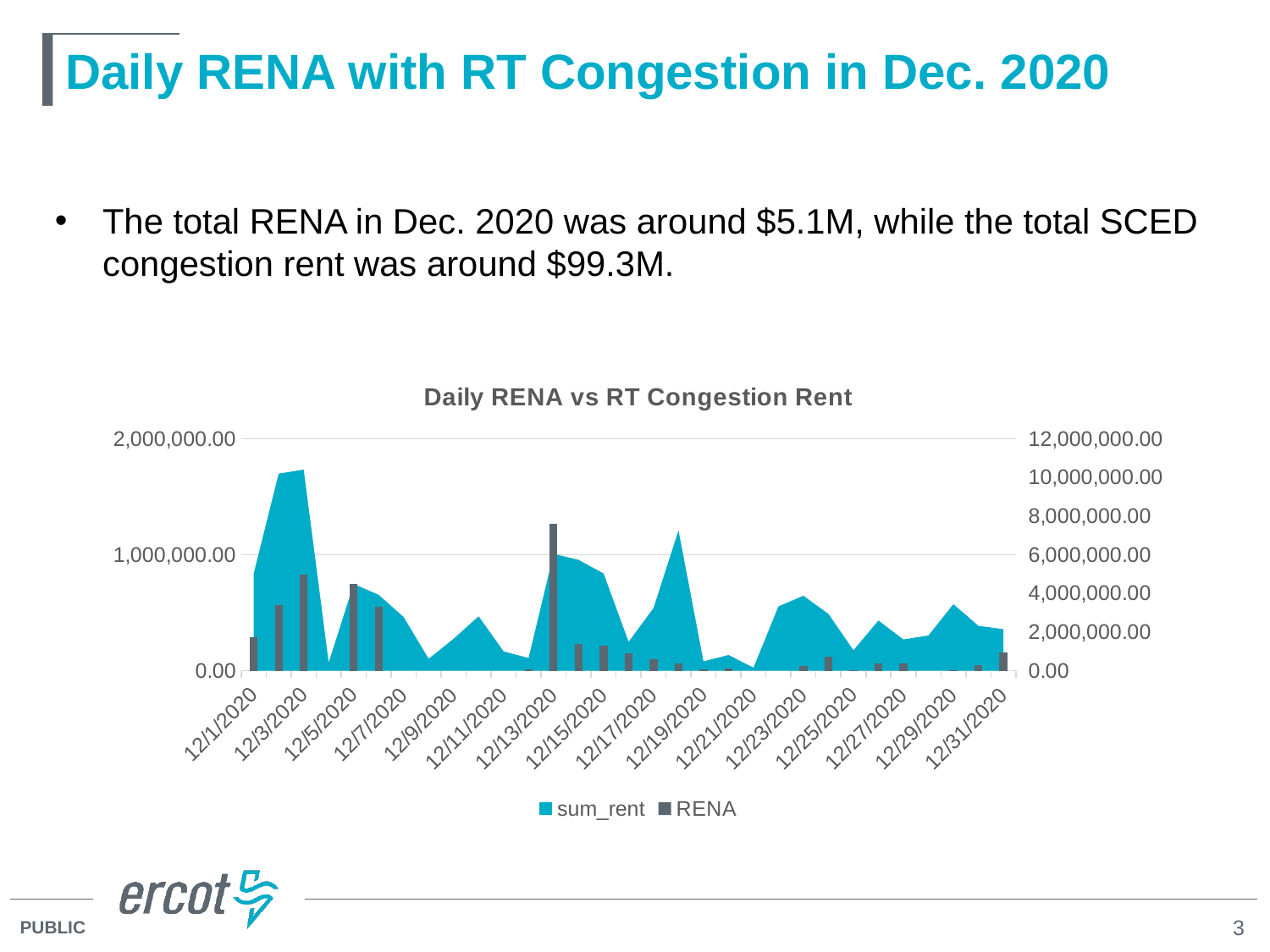
Which date has the larger RENA bar, 12/13/2020 or 12/21/2020? 12/13/2020 How many date labels are shown along the x axis? 16 What kind of chart is used to show the RENA series? bar chart What is the highest tick value shown on the left vertical axis? 2,000,000.00 How many series does the chart legend list? 2 Does the sum_rent series rise or fall between 12/3/2020 and 12/9/2020? fall On which date is the RENA bar the tallest? 12/13/2020 What are the two series named in the chart legend? sum_rent and RENA On which date does the sum_rent series reach its highest value? 12/3/2020 What kind of chart is used to show the sum_rent series? area chart What is the title of the chart on the slide? Daily RENA vs RT Congestion Rent Which date has the larger sum_rent value, 12/3/2020 or 12/21/2020? 12/3/2020